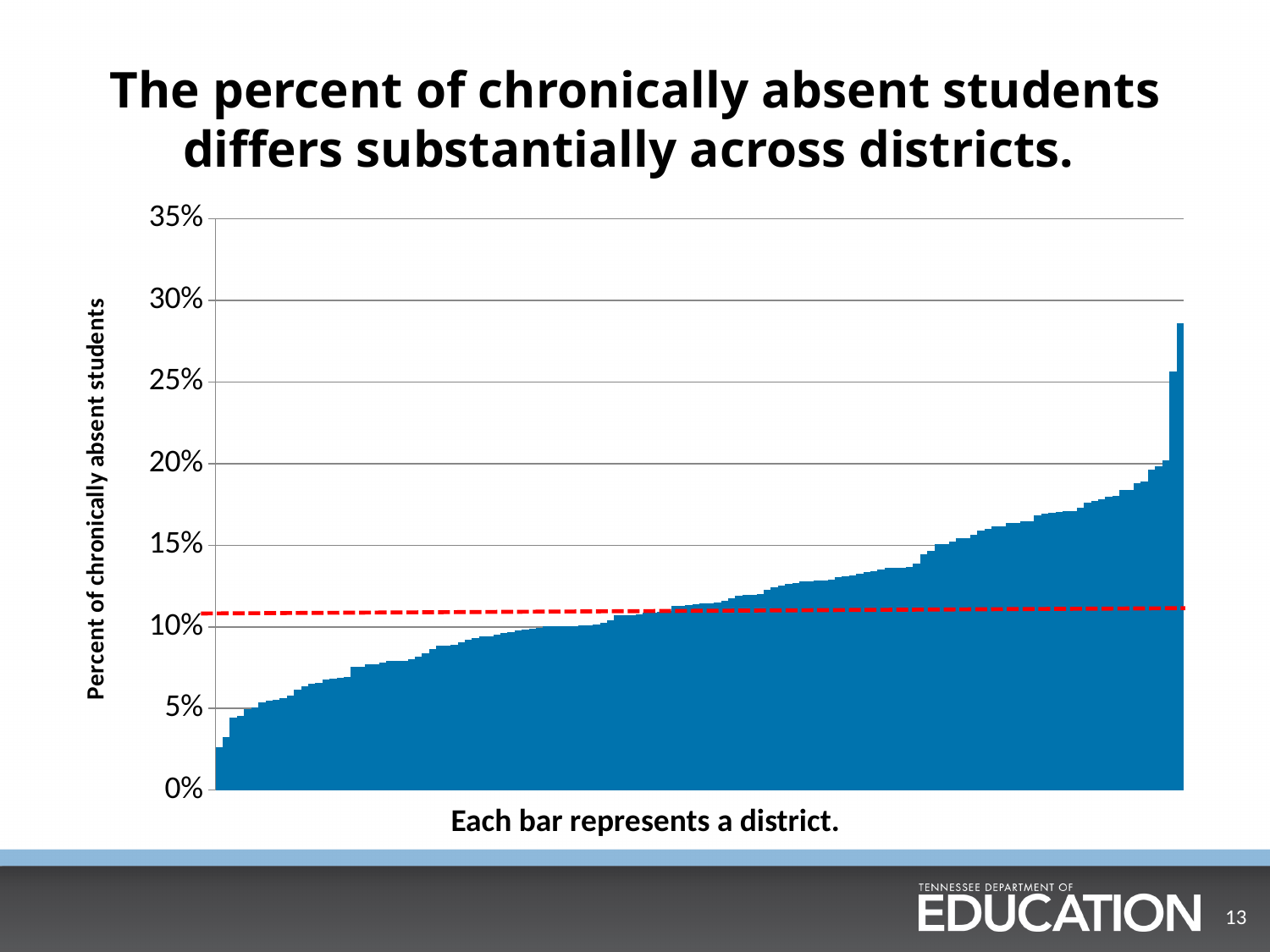
Is the level of the red dashed line greater or less than 15%? less Is the level of the red dashed line greater or less than 10%? greater Is the value for the shortest bar (leftmost district) greater or less than 5%? less What kind of chart is shown on the slide? bar chart What is the highest value shown on the y axis? 35% According to the caption below the chart, what does each bar represent? a district Do the bar values rise or fall from left to right along the x axis? rise